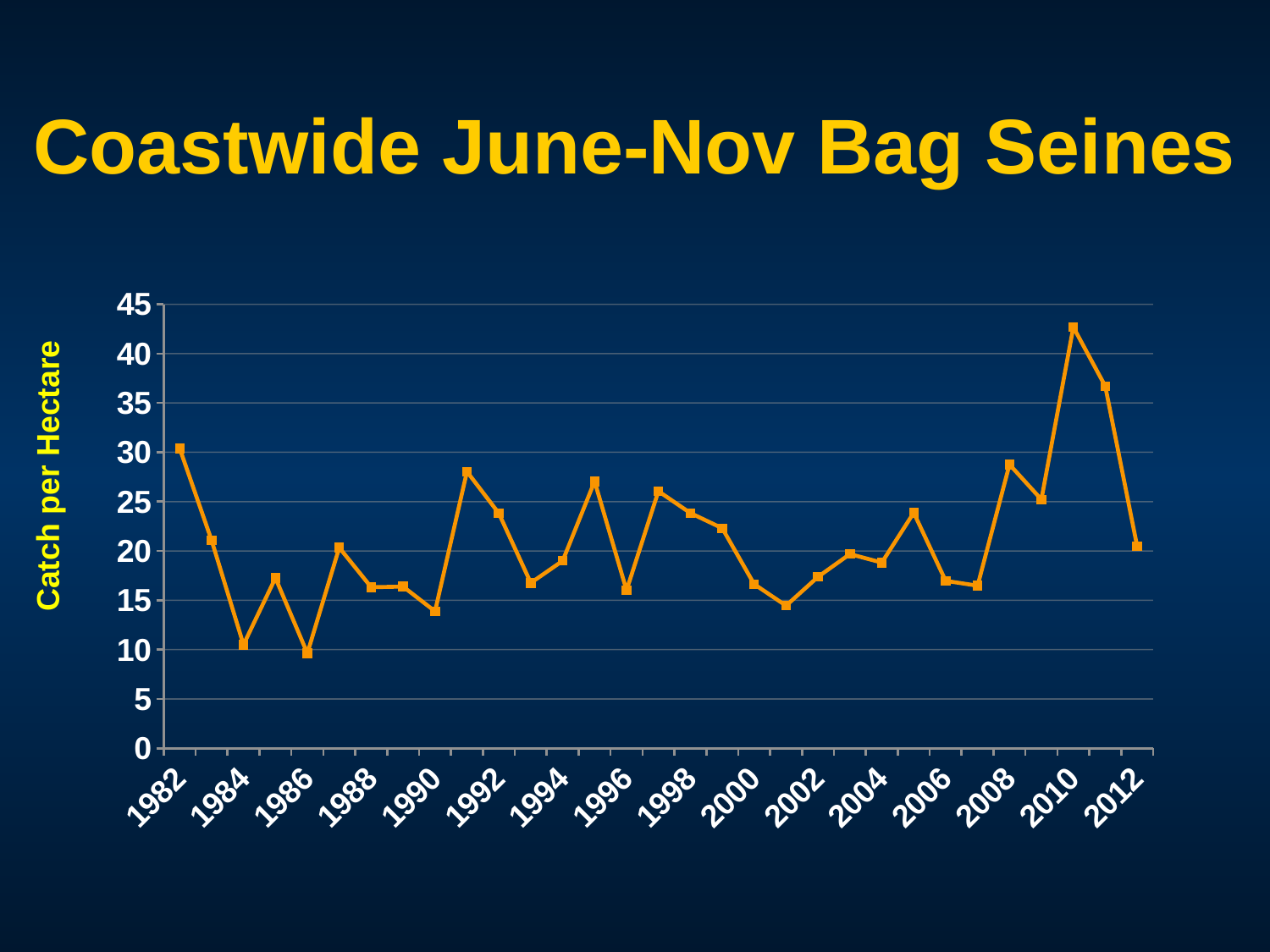
Is the value for 1986 greater or less than 15? less Which year has the larger catch per hectare, 1991 or 1996? 1991 Is the value for 2010 greater or less than 40? greater Is the value for 2012 greater or less than 25? less What kind of chart is shown on the slide? line chart Do the values rise or fall from 2010 to 2012? fall Which year has the highest catch per hectare? 2010 How many yearly data points are plotted on the chart? 31 Which year has the larger catch per hectare, 2010 or 1982? 2010 What is the label on the vertical axis? Catch per Hectare